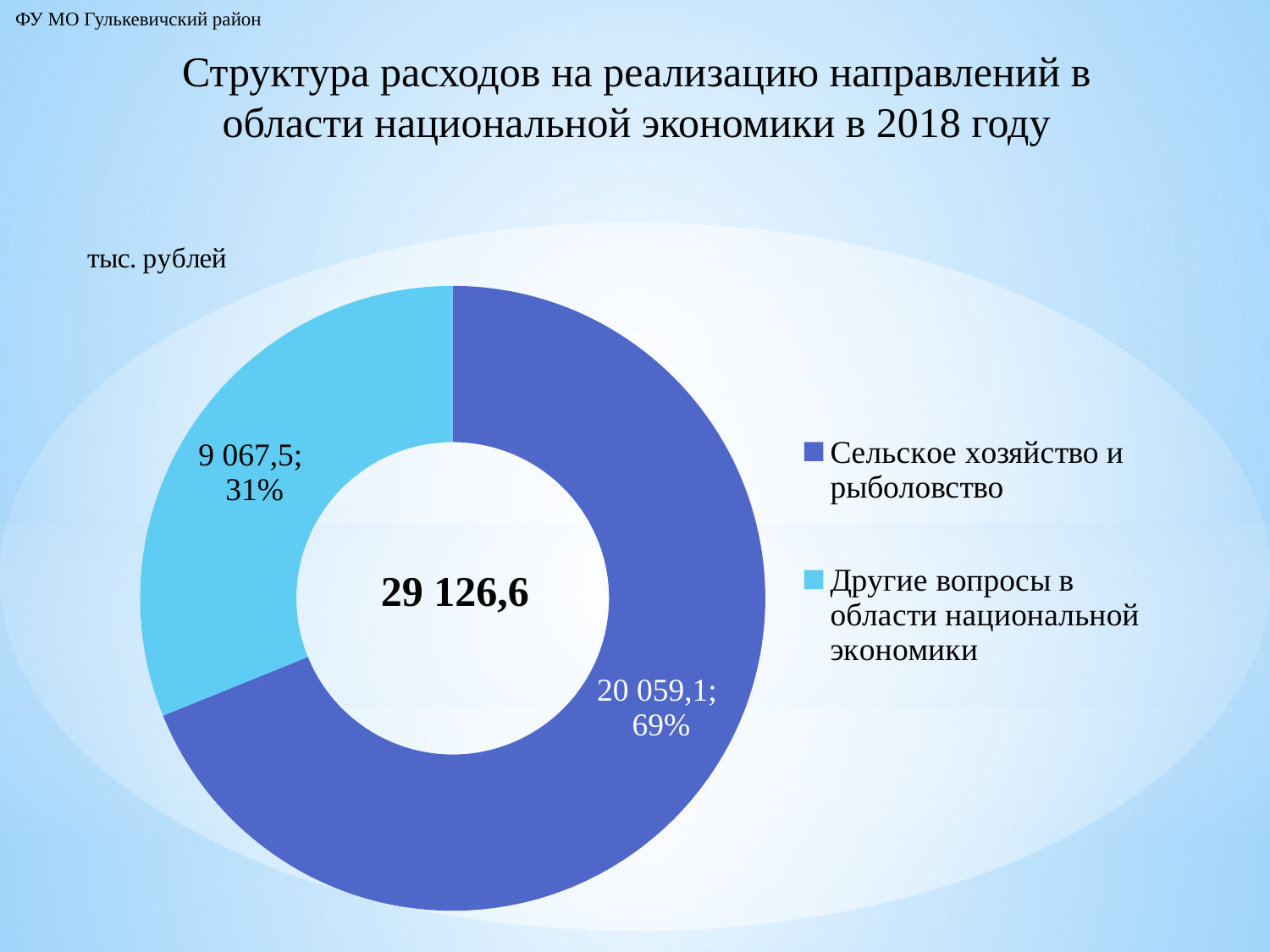
What is the difference between the values for "Сельское хозяйство и рыболовство" and "Другие вопросы в области национальной экономики"? 10 991,6 What share of the chart does "Другие вопросы в области национальной экономики" represent? 31% Which is larger: the value for "Сельское хозяйство и рыболовство" or for "Другие вопросы в области национальной экономики"? Сельское хозяйство и рыболовство Which category has the smallest value? Другие вопросы в области национальной экономики What is the value for "Сельское хозяйство и рыболовство"? 20 059,1 Which category has the largest value? Сельское хозяйство и рыболовство In what units are the chart values given? тыс. рублей How many categories does the chart show? 2 What is the total value shown in the centre of the chart? 29 126,6 What type of chart is shown on the slide? Doughnut (pie) chart What share of the chart does "Сельское хозяйство и рыболовство" represent? 69% What is the value for "Другие вопросы в области национальной экономики"? 9 067,5